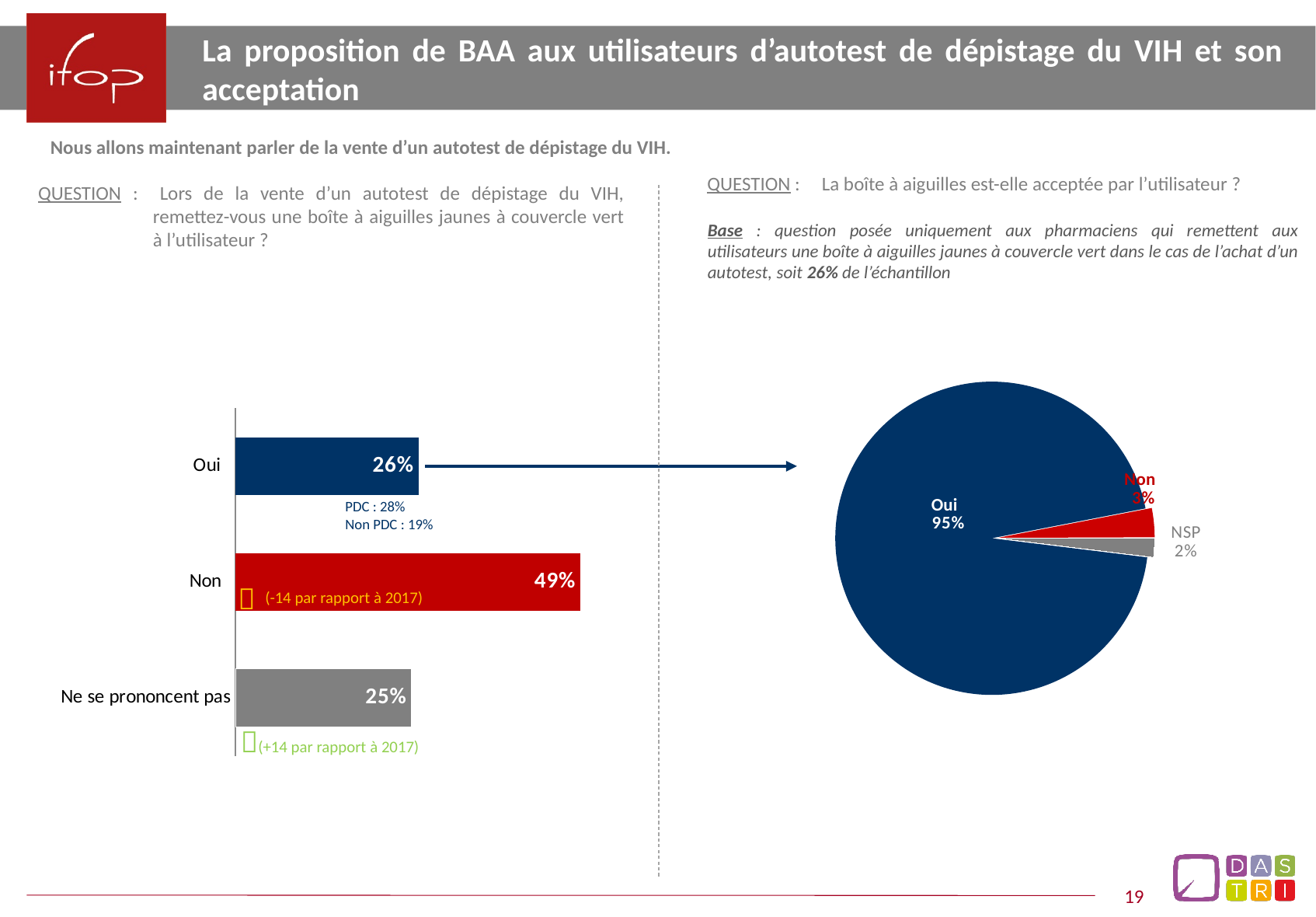
In the bar chart on the left, what is the value for "Non"? 49% In the bar chart on the left, how many categories are shown? 3 In the pie chart on the right, which slice is the smallest? NSP In the pie chart on the right, what is the value for "Non"? 3% In the pie chart on the right, what share does "Oui" have? 95% In the bar chart on the left, what is the value for "Oui"? 26% What type of chart is shown on the right side of the slide? Pie chart In the bar chart on the left, which category has the highest value? Non In the bar chart on the left, what is the difference between the values for "Non" and "Oui"? 23 percentage points In the bar chart on the left, what is the value for "Ne se prononcent pas"? 25% What type of chart is shown on the left side of the slide? Bar chart In the pie chart on the right, how many slices are there? 3